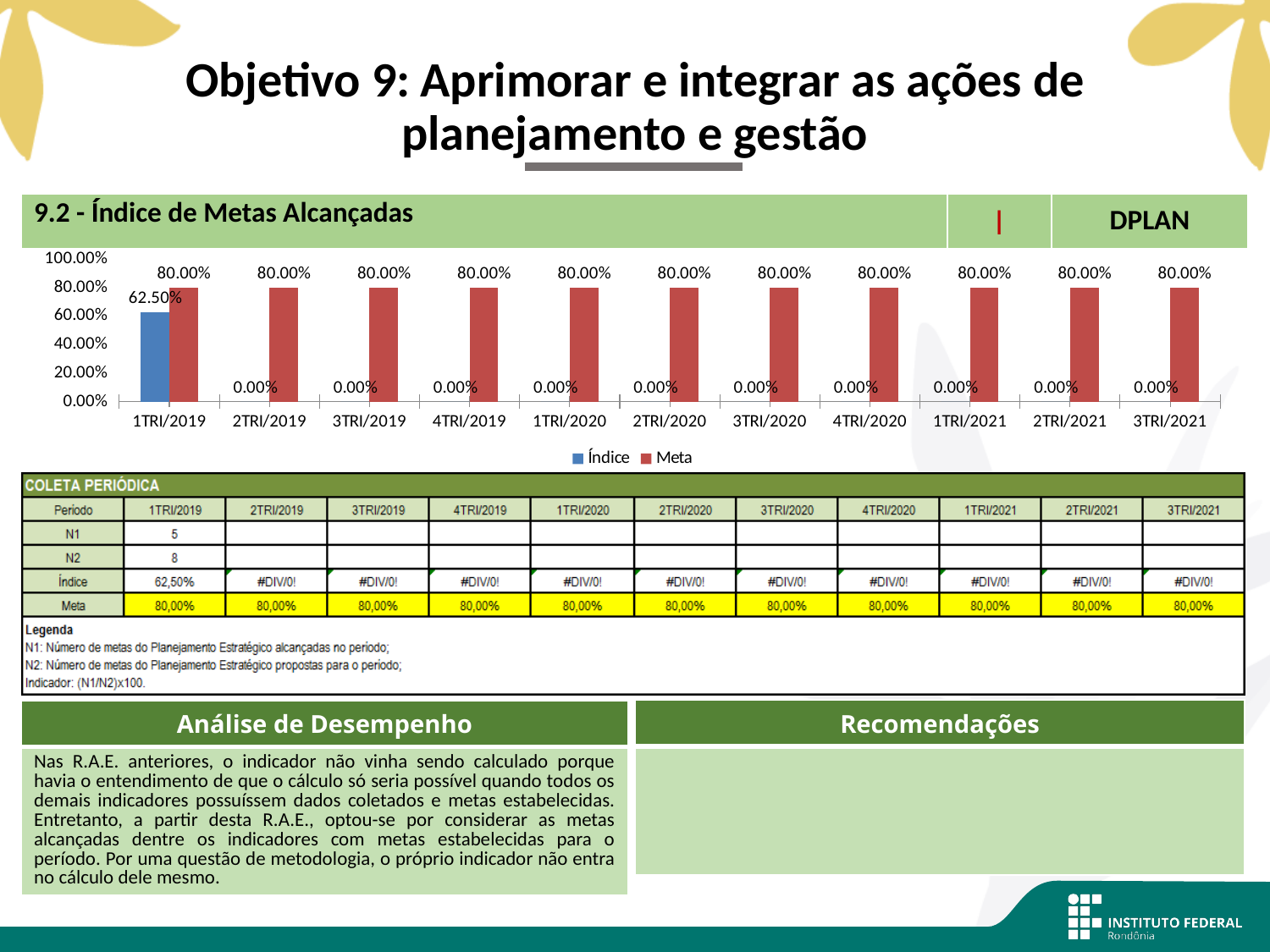
What type of chart is shown on the slide? bar chart What is the difference between Meta and Índice for 1TRI/2019? 17.50% Which period has the highest Índice value? 1TRI/2019 What is the value of Meta for 3TRI/2021? 80.00% What is the value of Índice for 2TRI/2020? 0.00% What is the value of Índice for 1TRI/2019? 62.50% How many periods are shown on the x axis of the chart? 11 Does the Meta series rise, fall or stay flat across the periods on the x axis? stays flat How many series does the chart legend list? 2 Is the Índice value for 1TRI/2019 greater or less than 60.00%? greater Which is larger for 1TRI/2019, Índice or Meta? Meta What are the names of the two series in the chart legend? Índice and Meta